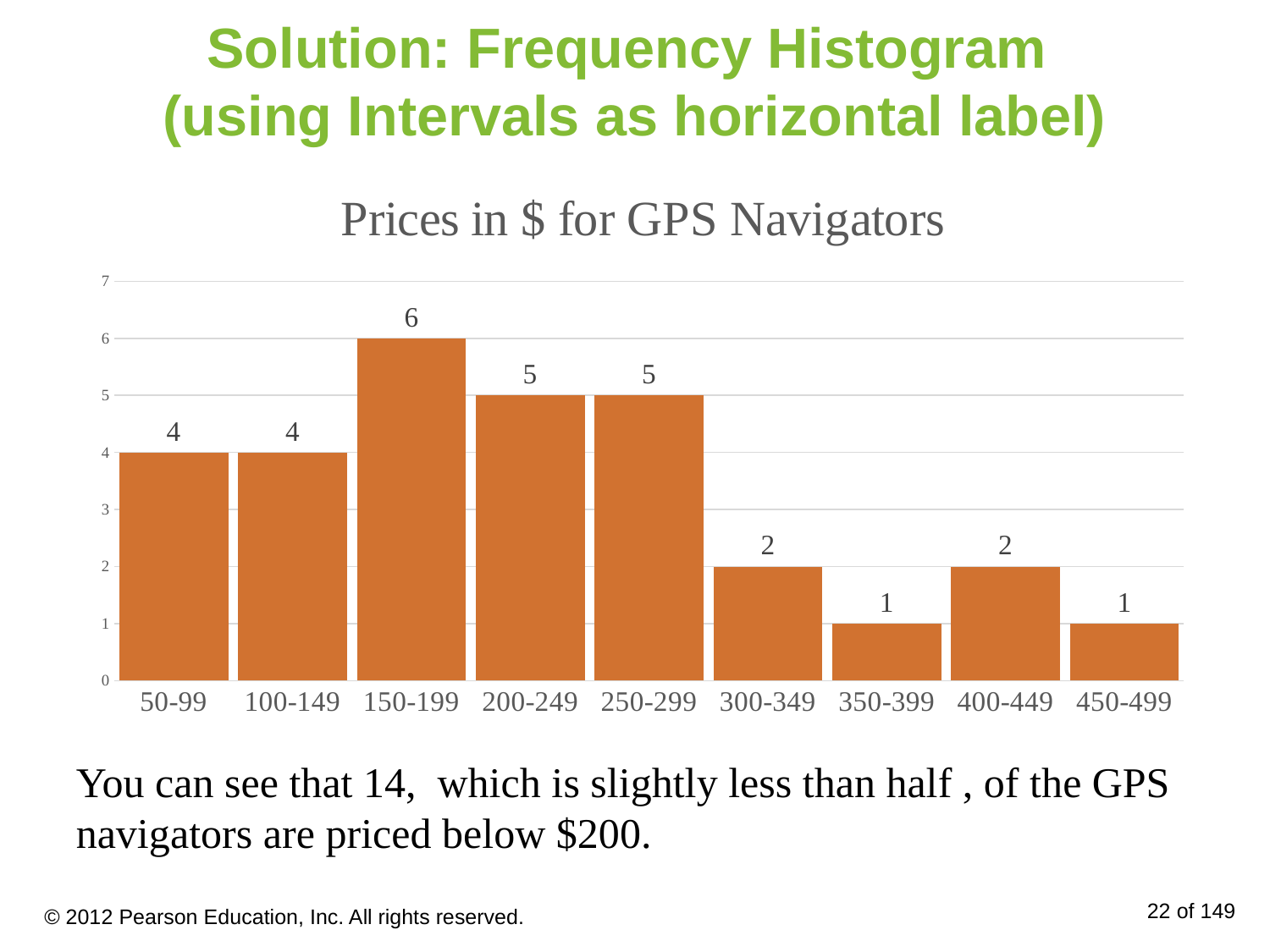
How many price intervals are shown on the x axis? 9 What is the difference between the frequencies for 200-249 and 400-449? 3 Which interval has the highest frequency? 150-199 What is the highest value shown on the vertical axis? 7 What is the frequency for the 150-199 interval? 6 What is the frequency for the 300-349 interval? 2 What is the frequency for the 50-99 interval? 4 What kind of chart is shown on the slide? bar chart What is the title of the chart? Prices in $ for GPS Navigators Which has a higher frequency, 300-349 or 450-499? 300-349 What is the difference between the frequencies for 150-199 and 350-399? 5 Which has a higher frequency, 100-149 or 250-299? 250-299